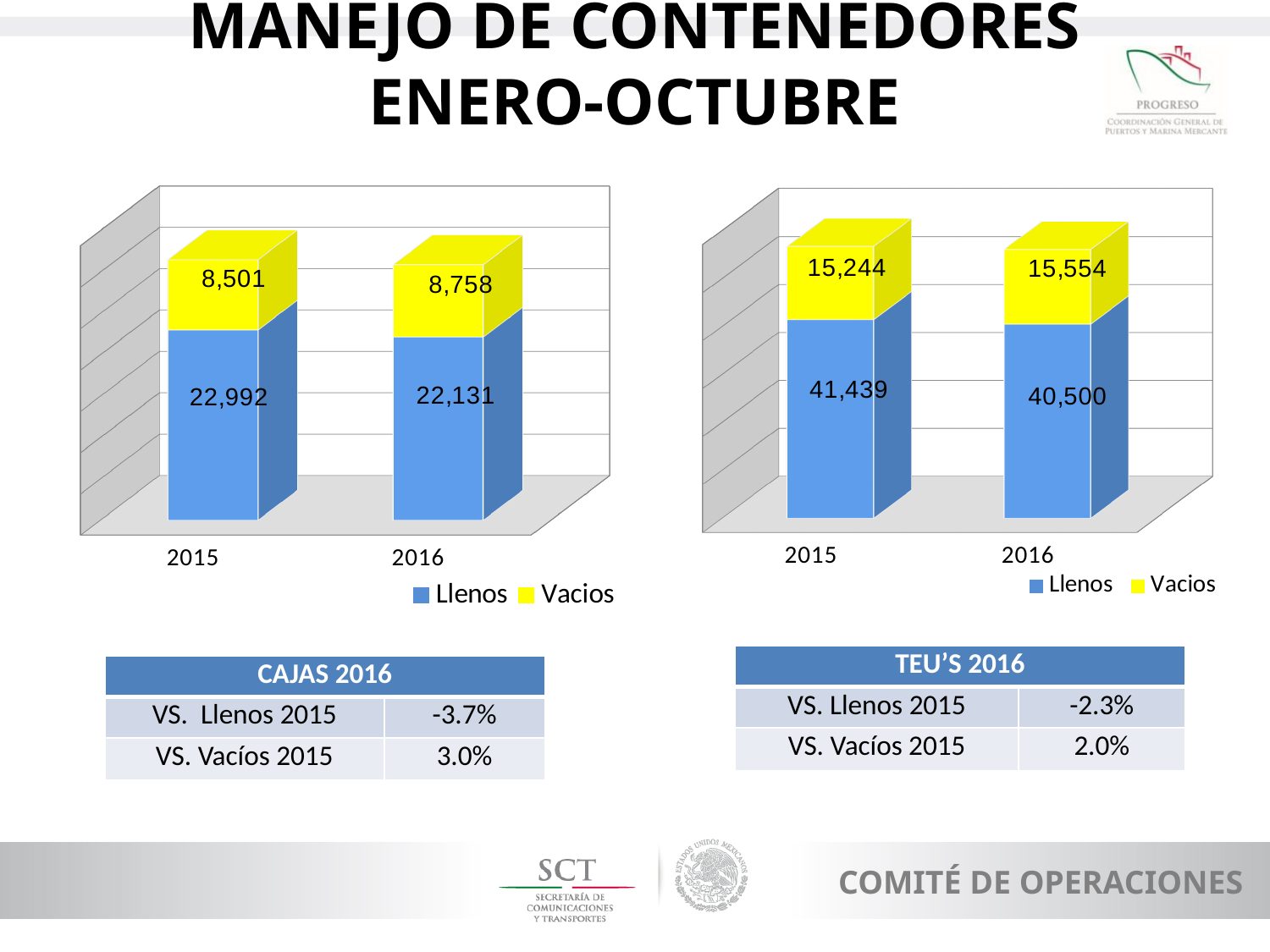
In the right chart, which year has the larger Llenos value, 2015 or 2016? 2015 In the right chart, what is the value for Vacios in 2015? 15,244 In the left chart, what is the value for Vacios in 2016? 8,758 In the right chart, what is the difference between the Vacios values for 2016 and 2015? 310 How many series does the legend of the left chart list? 2 In the left chart, what is the difference between the Llenos values for 2015 and 2016? 861 In the right chart, what is the value for Llenos in 2016? 40,500 What kind of chart is the left chart? Stacked bar chart In the left chart, what is the value for Llenos in 2015? 22,992 In the left chart, what is the total of the stacked bar for 2015? 31,493 In the right chart, what is the total of the stacked bar for 2016? 56,054 How many categories are shown on the x axis of the right chart? 2